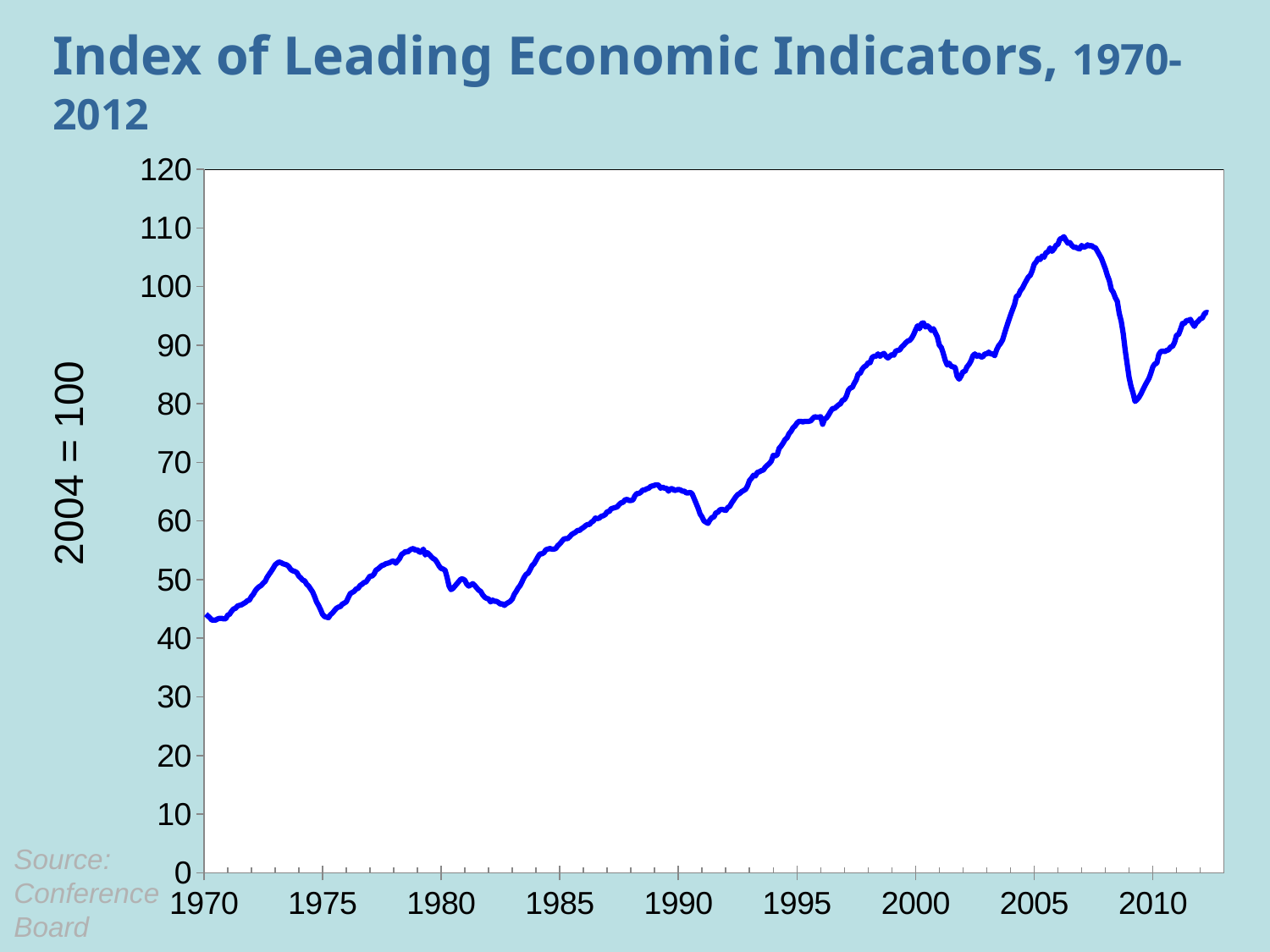
What is the title of the chart? Index of Leading Economic Indicators, 1970-2012 What is the label on the vertical axis? 2004 = 100 Which year has the higher index value, 1995 or 2005? 2005 Does the index rise or fall between 2007 and 2009? fall Is the value of the index in 1990 greater or less than 60? greater What kind of chart is shown on the slide? line chart Is the value of the index in 1970 greater or less than 50? less Does the highest point of the line occur before or after 2000? after Is the value of the index in 1985 greater or less than 50? greater Overall, does the index rise or fall from 1970 to 2012? rise